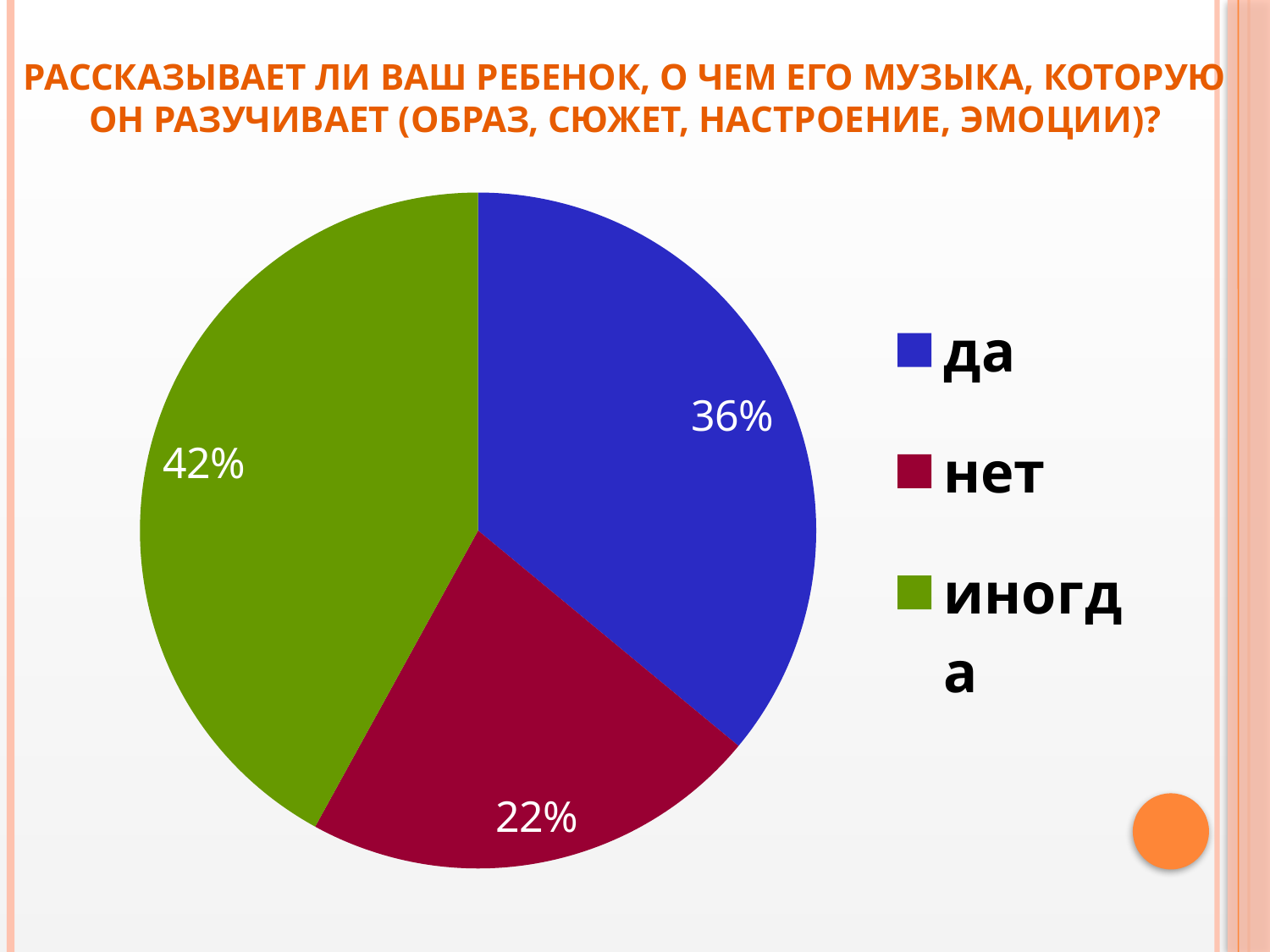
What is the difference in percentage points between the "да" and "нет" slices? 14 Which is larger, the "да" slice or the "нет" slice? да What percentage is shown for the "да" slice? 36% What colour is the "да" slice? blue What kind of chart is shown on the slide? pie chart Which category has the largest share of the pie? иногда What percentage is shown for the "иногда" slice? 42% What is the difference in percentage points between the "иногда" and "да" slices? 6 What colour is the "иногда" slice? green Which category has the smallest share of the pie? нет What percentage is shown for the "нет" slice? 22% How many slices does the pie chart have? 3